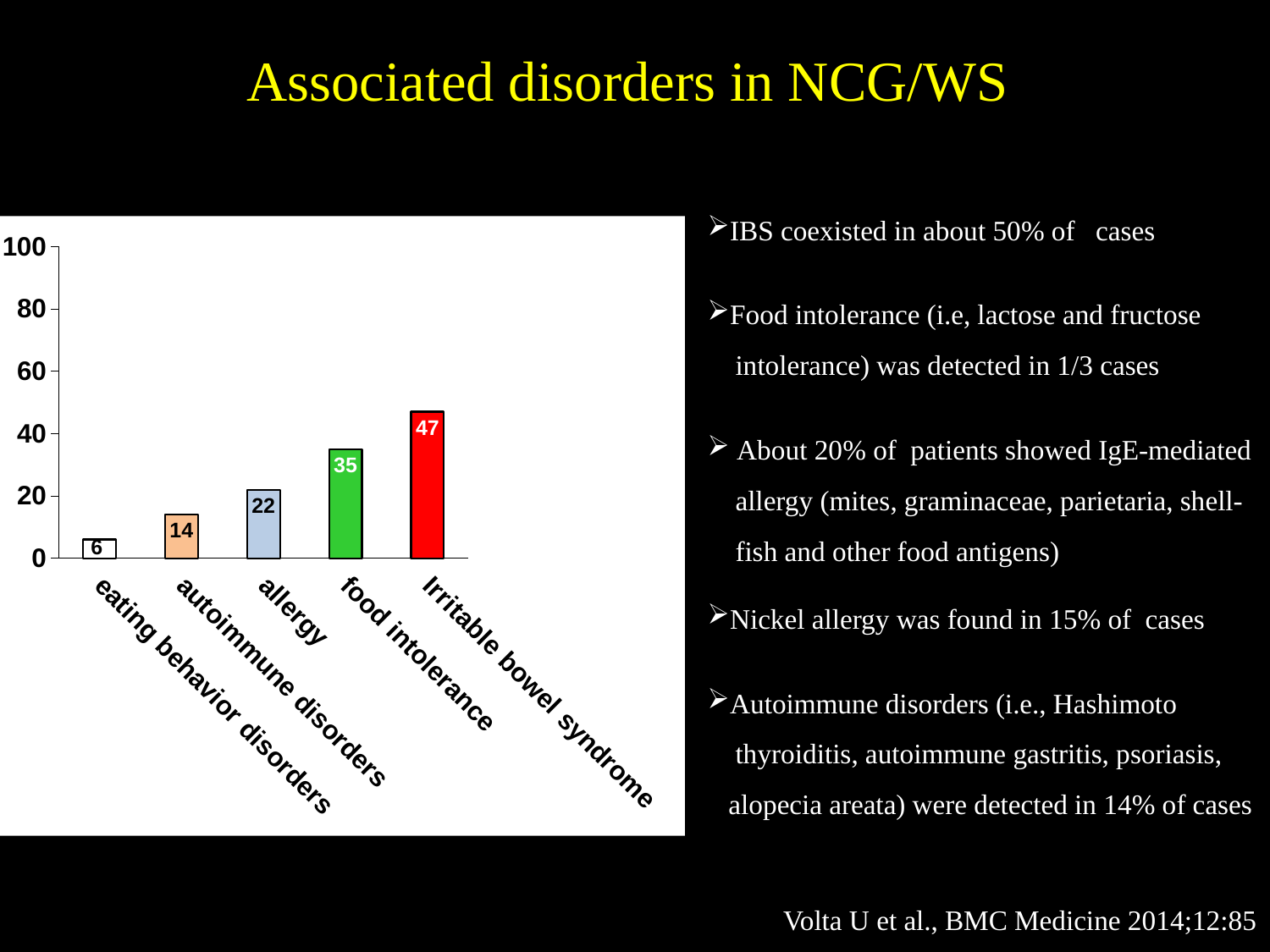
What is the value for food intolerance? 35 Which category has the lowest value? eating behavior disorders How many categories are shown in the chart? 5 What is the value for allergy? 22 What is the difference between the values for allergy and eating behavior disorders? 16 What is the difference between the values for Irritable bowel syndrome and food intolerance? 12 Which category has the highest value? Irritable bowel syndrome Do the values rise or fall from left to right along the x axis? rise What kind of chart is shown on the slide? bar chart Which is larger, the value for allergy or the value for autoimmune disorders? allergy What is the value for autoimmune disorders? 14 Is the value for Irritable bowel syndrome greater or less than 40? greater